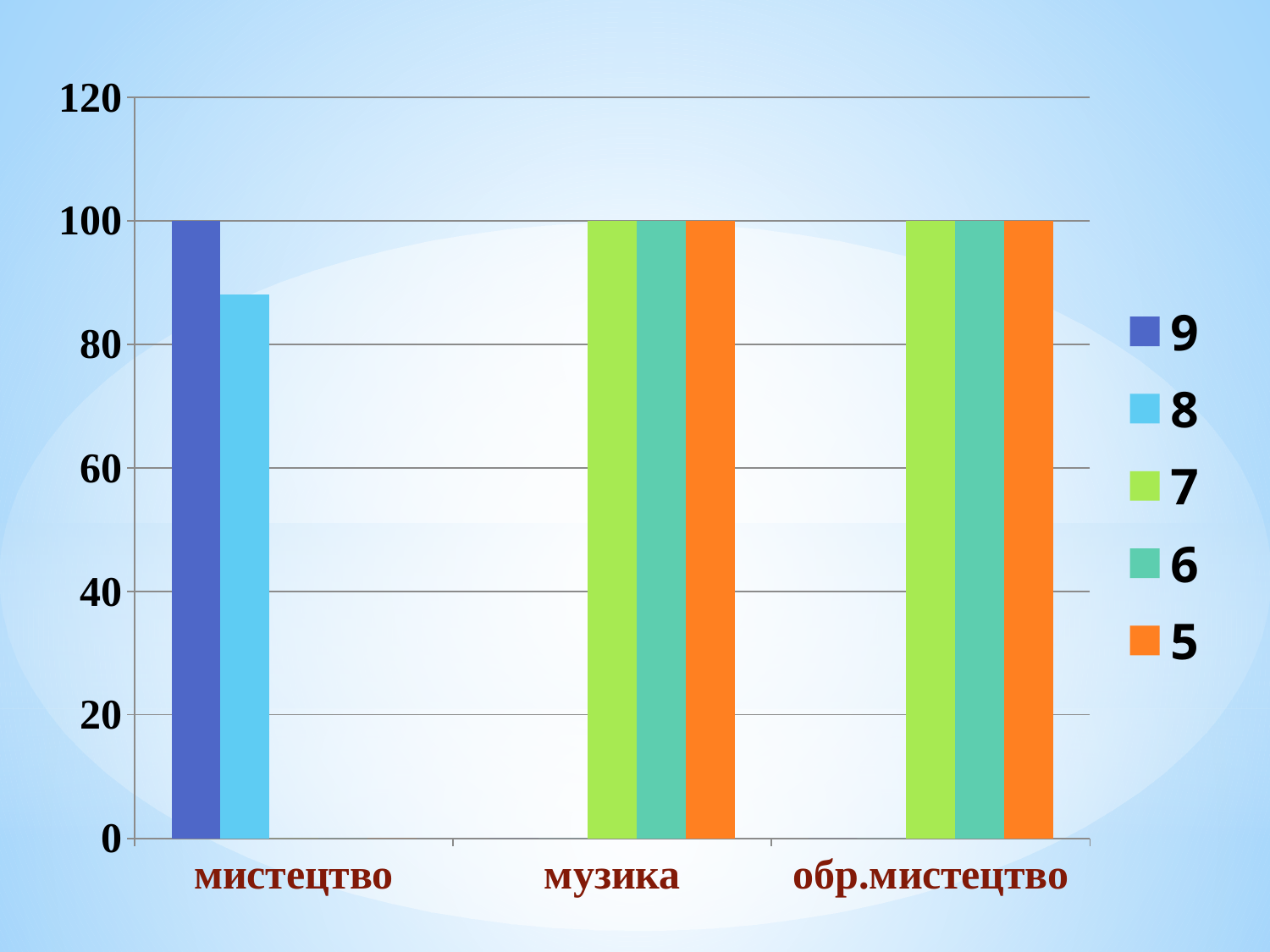
What is the value of series 5 for обр.мистецтво? 100 What colour represents series 5 in the legend? orange For мистецтво, which series has the larger value, 9 or 8? 9 What kind of chart is shown on the slide? bar chart Is the value of series 8 for мистецтво greater or less than 100? less How many series does the legend list? 5 Is the value of series 8 for мистецтво greater or less than 80? greater Which series have bars shown for the музика category? 7, 6, 5 What is the value of series 7 for музика? 100 How many categories are shown on the x axis? 3 What is the value of series 9 for мистецтво? 100